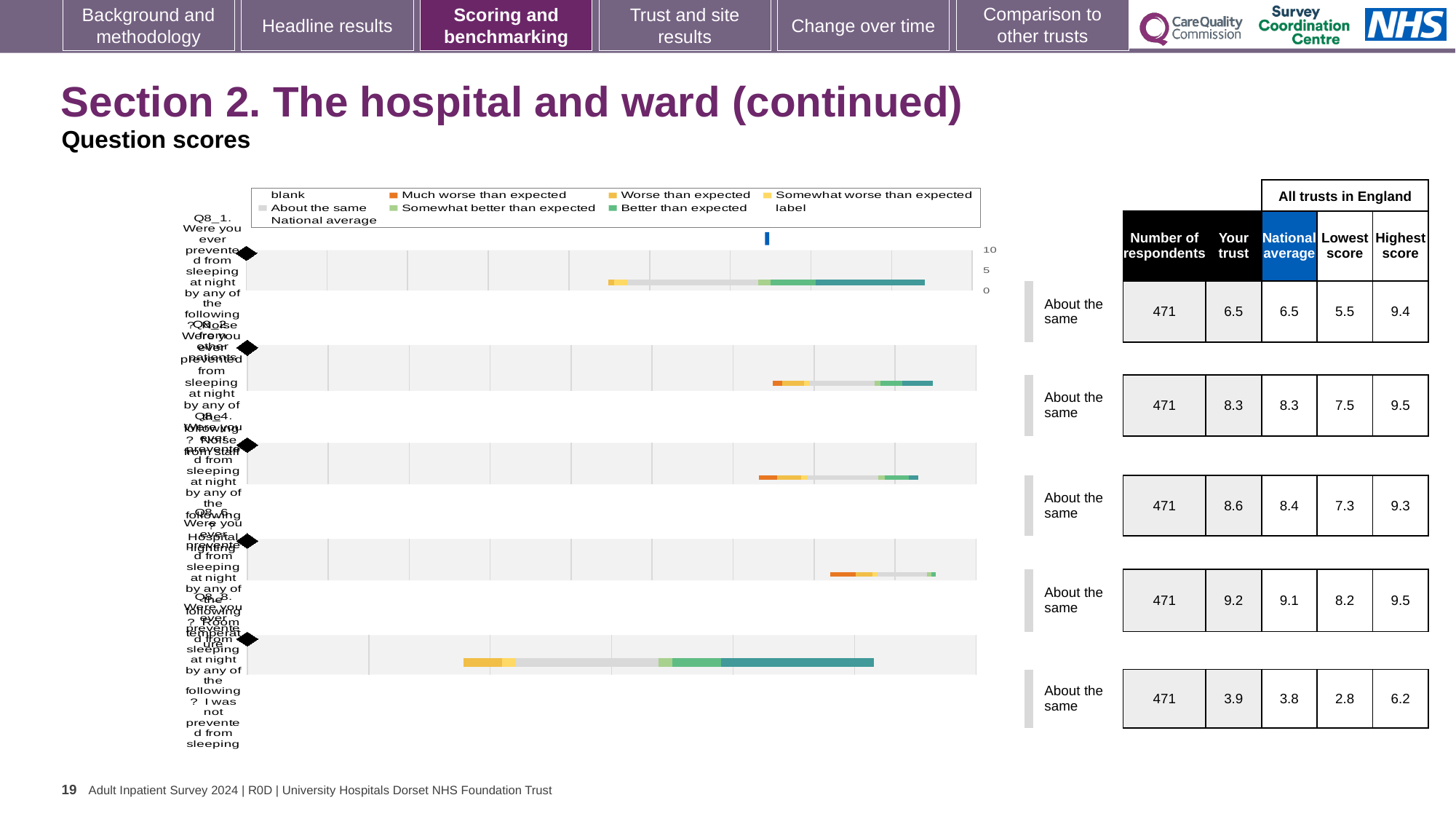
What kind of chart is used to show the question scores on this slide? bar chart In the fourth row, which is larger: the 'Your trust' score or the 'National average'? Your trust (9.2) How many question rows (bars) are plotted in the chart? 5 In the third row, what is the difference between the 'Your trust' score and the 'National average'? 0.2 In the second row, what is the 'Lowest score' among all trusts in England? 7.5 What is the number of respondents shown for each row in the table? 471 What benchmark label is shown beside each bar in the chart? About the same Which row has the highest 'Your trust' score in the table? the fourth row (9.2) In the table next to the chart, what is the 'Highest score' for the last (fifth) row? 6.2 Which row has the lowest 'Your trust' score in the table? the fifth row (3.9) In the table next to the chart, what is the 'Your trust' score for the first row? 6.5 In the fifth row, what is the difference between the 'Highest score' and the 'Lowest score'? 3.4